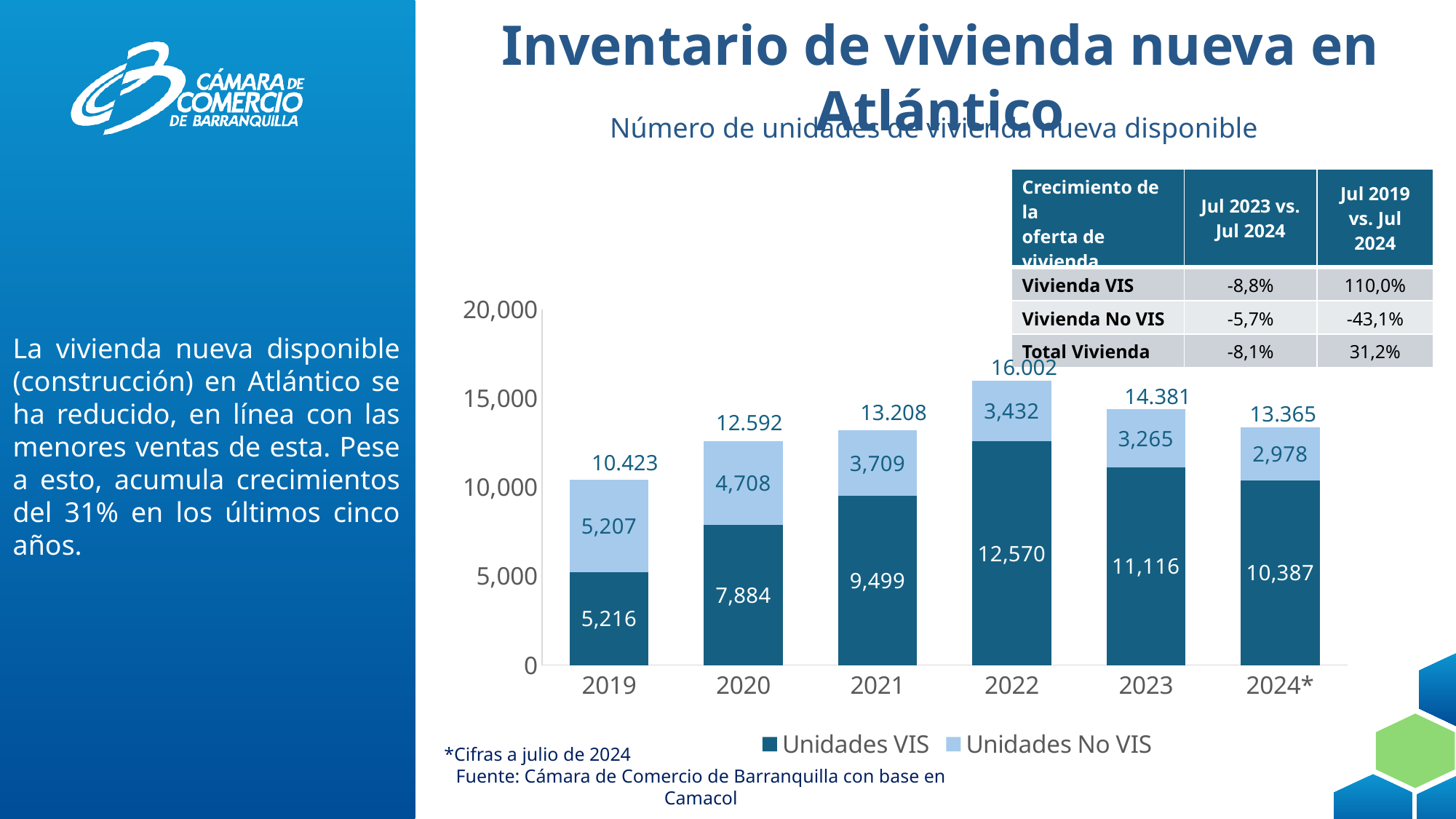
What is the total shown above the bar for 2023? 14.381 What is the value for Unidades VIS in 2022? 12,570 Which is larger, Unidades No VIS in 2020 or Unidades No VIS in 2021? Unidades No VIS in 2020 How many years are shown on the x axis of the chart? 6 What is the difference between Unidades VIS in 2023 and Unidades VIS in 2024*? 729 Does the value for Unidades No VIS rise or fall from 2019 to 2024*? Fall Is the total bar for 2022 greater or less than 15,000? greater Which year has the lowest value for Unidades No VIS? 2024* Which year has the highest value for Unidades VIS? 2022 What kind of chart is shown on the slide? Stacked bar chart How many series does the chart legend list? 2 What is the value for Unidades No VIS in 2019? 5,207